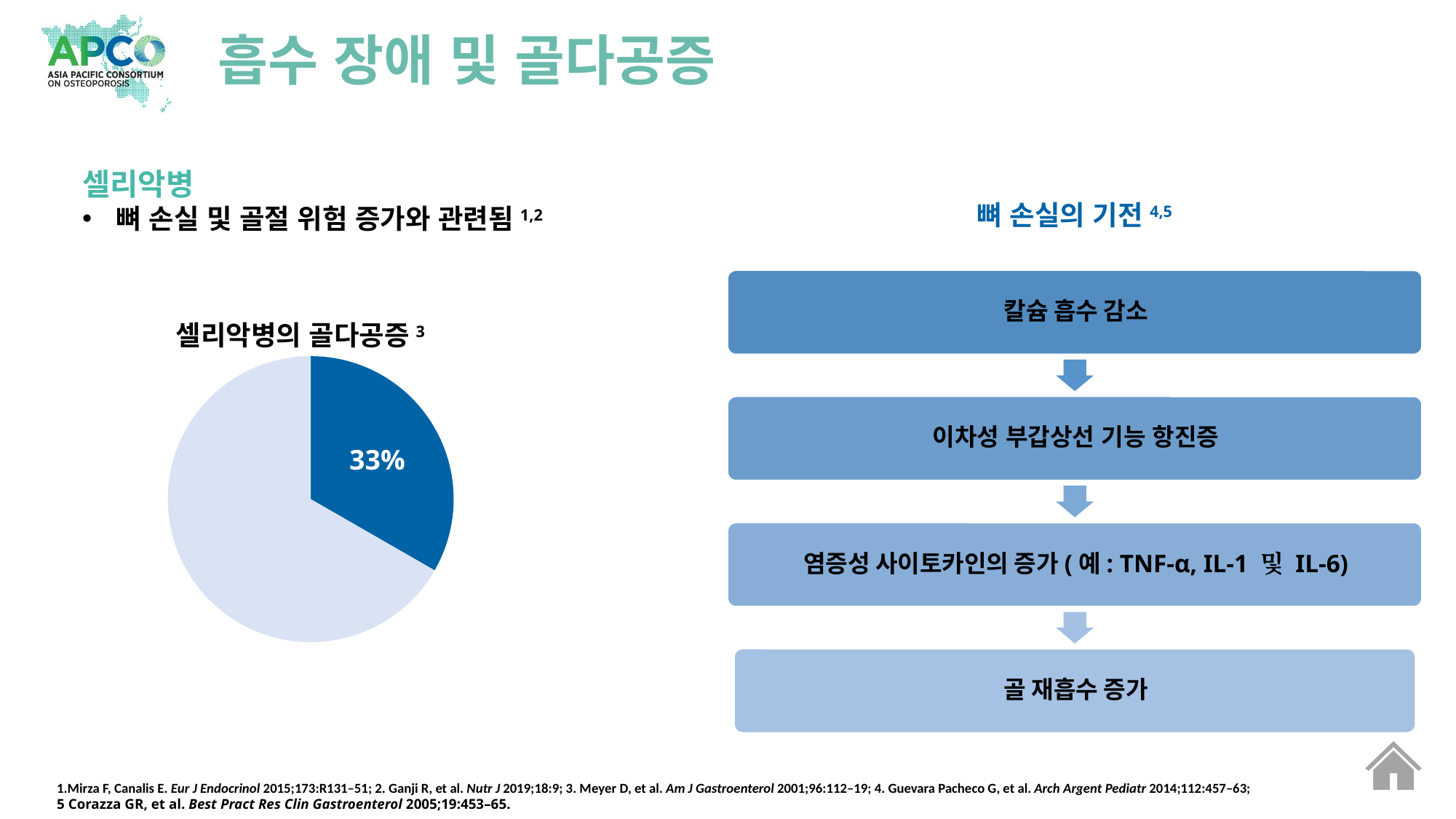
Which slice of the pie chart is the smallest? the dark blue slice (33%) How many slices does the pie chart have? 2 Which slice of the pie chart is larger, the dark blue slice or the light blue slice? the light blue slice What percentage is printed on the dark blue slice of the pie chart? 33% What kind of chart is shown on the slide? pie chart What is the title of the pie chart? 셀리악병의 골다공증 How many slices of the pie chart have a data label printed on them? 1 What share of the pie does the dark blue slice represent? 33%